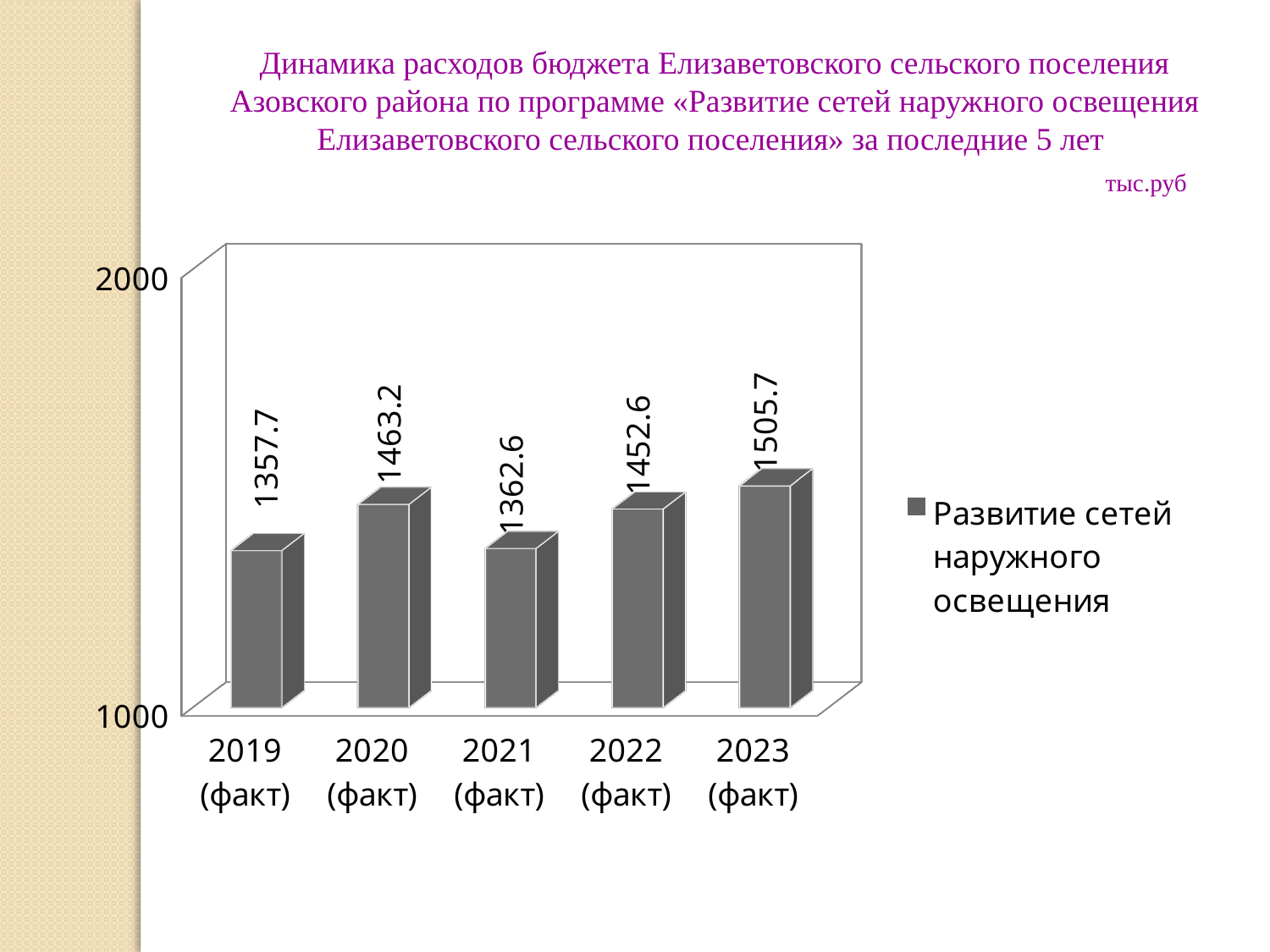
What is the legend entry for the series? Развитие сетей наружного освещения Is the value for 2023 (факт) greater or less than 2000? less What is the value for 2019 (факт)? 1357.7 What is the value for 2021 (факт)? 1362.6 What is the difference between the values for 2020 (факт) and 2021 (факт)? 100.6 What is the difference between the values for 2023 (факт) and 2019 (факт)? 148 How many years are shown on the x axis? 5 Which year has the highest value? 2023 (факт) What is the value for 2023 (факт)? 1505.7 What kind of chart is shown on the slide? bar chart Which year has the lowest value? 2019 (факт) Which is larger, the value for 2020 (факт) or 2022 (факт)? 2020 (факт)